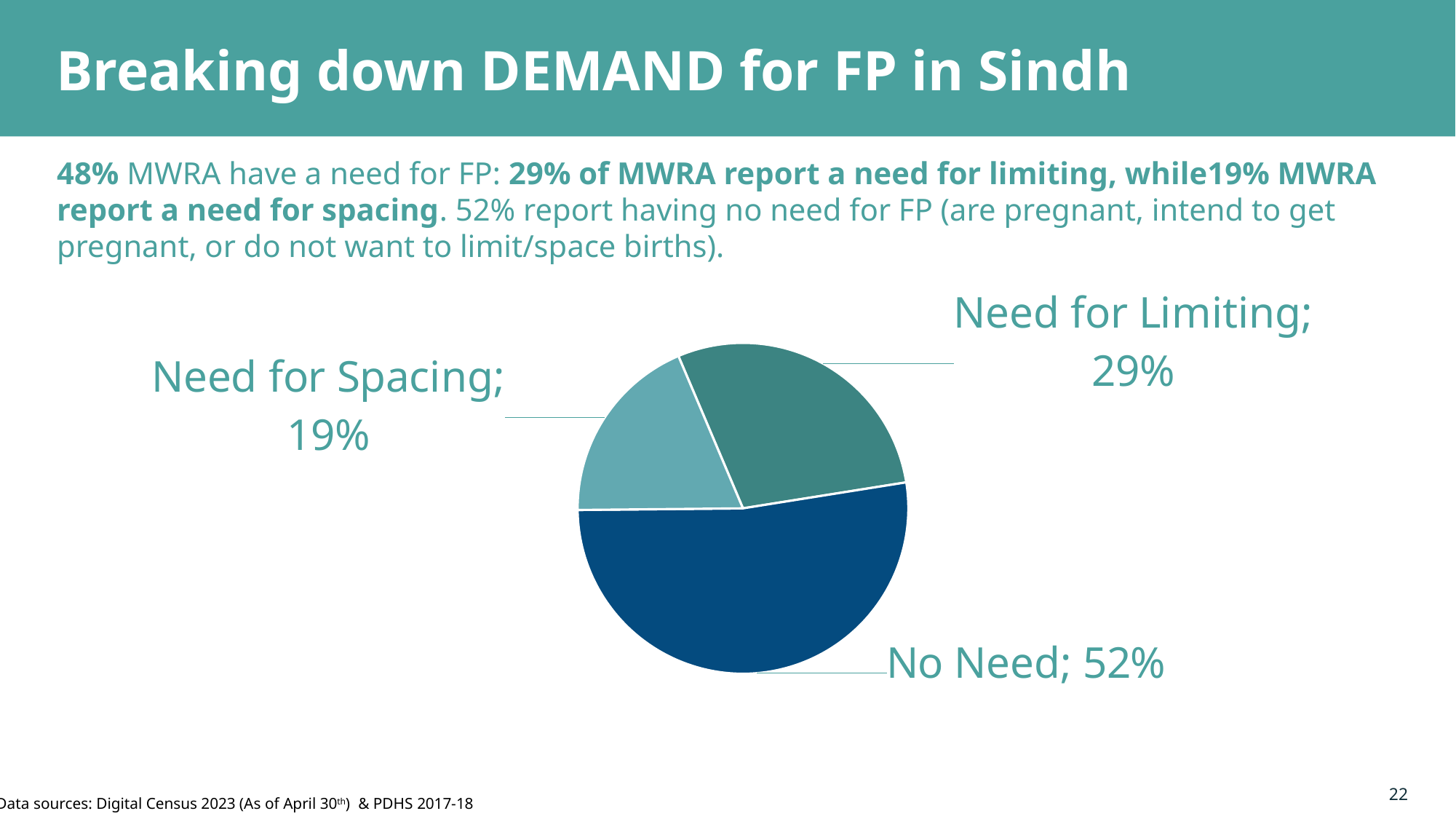
What is the difference between the No Need share and the Need for Limiting share? 23% What is the difference between the Need for Limiting share and the Need for Spacing share? 10% What kind of chart is shown on the slide? pie chart What share of the pie is labelled Need for Spacing? 19% How many slices does the pie chart have? 3 Which slice of the pie is the smallest? Need for Spacing What share of the pie is labelled No Need? 52% Which is larger, the Need for Limiting slice or the Need for Spacing slice? Need for Limiting What colour is the No Need slice of the pie? dark blue Which slice of the pie is the largest? No Need What share of the pie is labelled Need for Limiting? 29% What is the combined share of the Need for Limiting and Need for Spacing slices? 48%